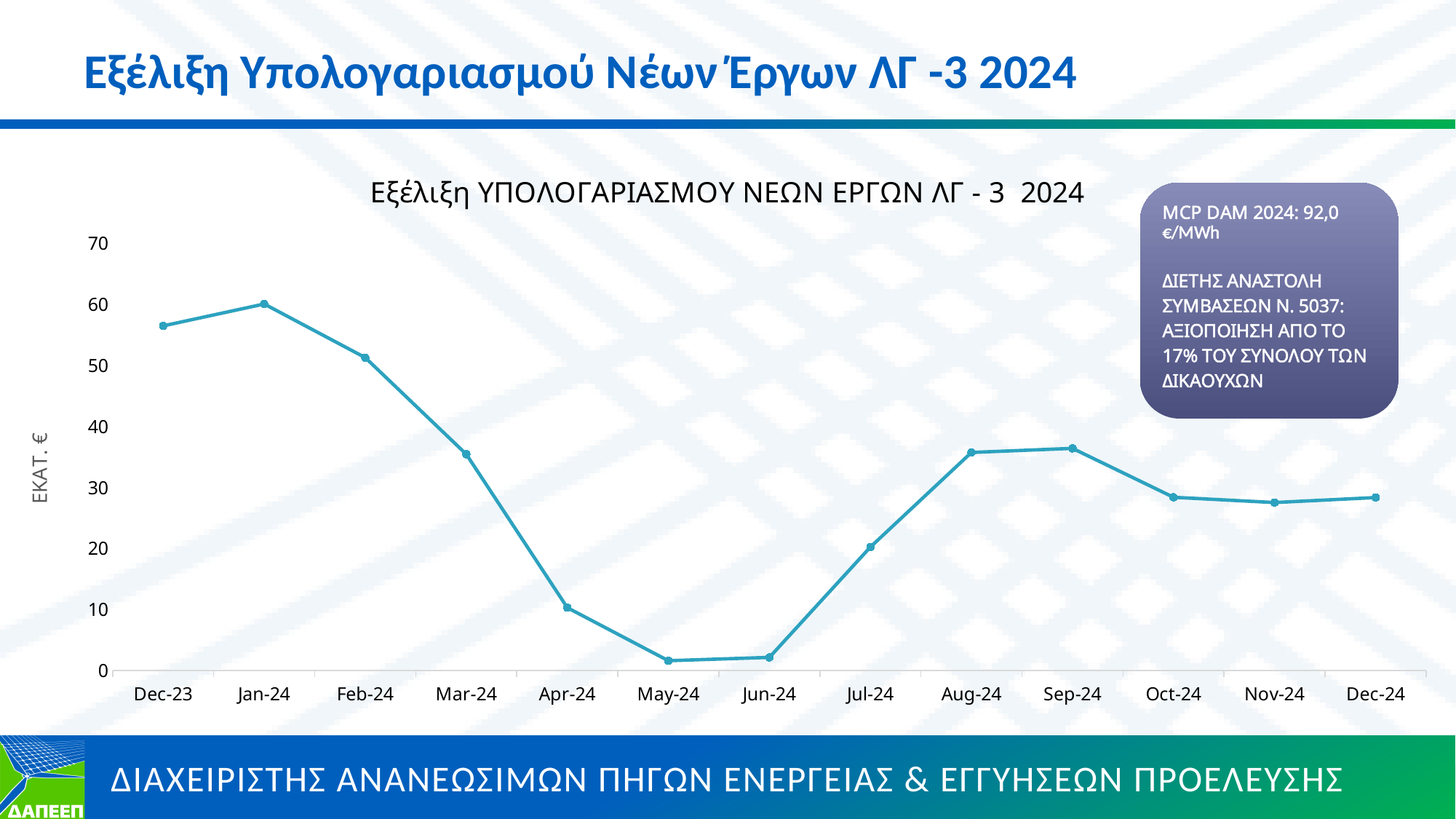
Which is larger, the value for Feb-24 or the value for Mar-24? Feb-24 Is the value for Aug-24 greater or less than 30? greater How many data points are plotted on the line? 13 Is the value for Apr-24 greater or less than 20? less Which month has the highest value on the chart? Jan-24 Is the value for Mar-24 greater or less than 30? greater What is the label on the vertical axis of the chart? ΕΚΑΤ. € Do the values rise or fall from Jun-24 to Sep-24? rise Do the values rise or fall from Jan-24 to May-24? fall What kind of chart is shown on the slide? line chart